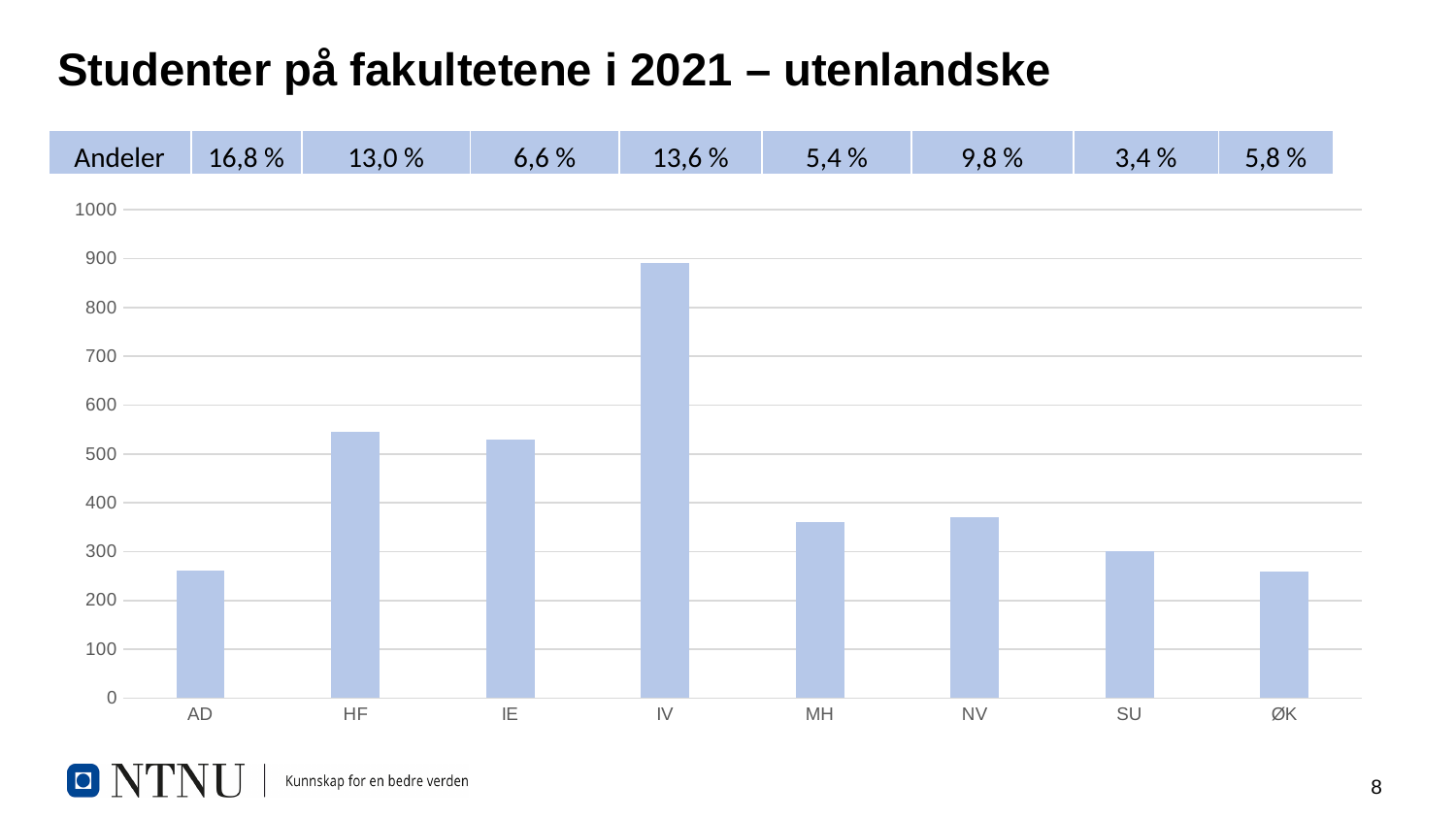
Which has a larger value, IV or HF? IV Is the value for HF greater or less than 500? greater Which faculty has the highest bar in the chart? IV Is the value for IV greater or less than 800? greater Is the value for AD greater or less than 300? less What is the 'Andeler' share shown for SU? 3,4 % What is the title of the slide containing the chart? Studenter på fakultetene i 2021 – utenlandske What is the 'Andeler' share shown for AD? 16,8 % How many faculties (categories) are shown on the x axis of the chart? 8 What type of chart is shown on the slide? bar chart What is the 'Andeler' share shown for NV? 9,8 %